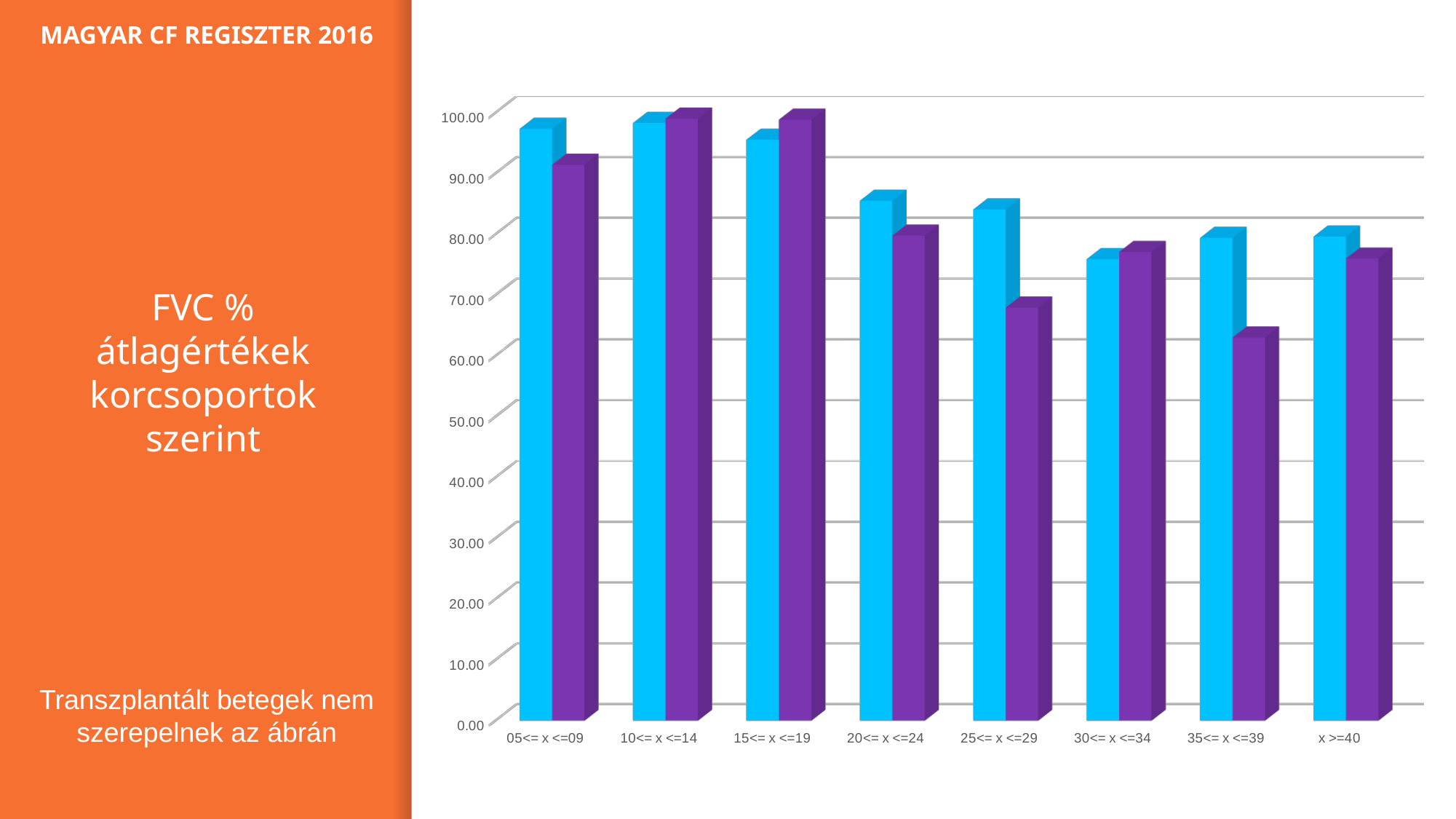
What is the title of the chart given on the slide? FVC % átlagértékek korcsoportok szerint For the 35<= x <=39 age group, which bar is taller, the cyan one or the purple one? the cyan one Is the value of the purple bar for 20<= x <=24 greater or less than 90? less Do the cyan bars generally rise or fall across the age groups from left to right? fall Which age group has the lowest purple bar? 35<= x <=39 Is the value of the purple bar for 25<= x <=29 greater or less than 80? less How many bars are plotted for each age group? 2 What kind of chart is shown on the slide? bar chart How many age-group categories are shown on the x axis? 8 Is the value of the cyan bar for x >=40 greater or less than 70? greater